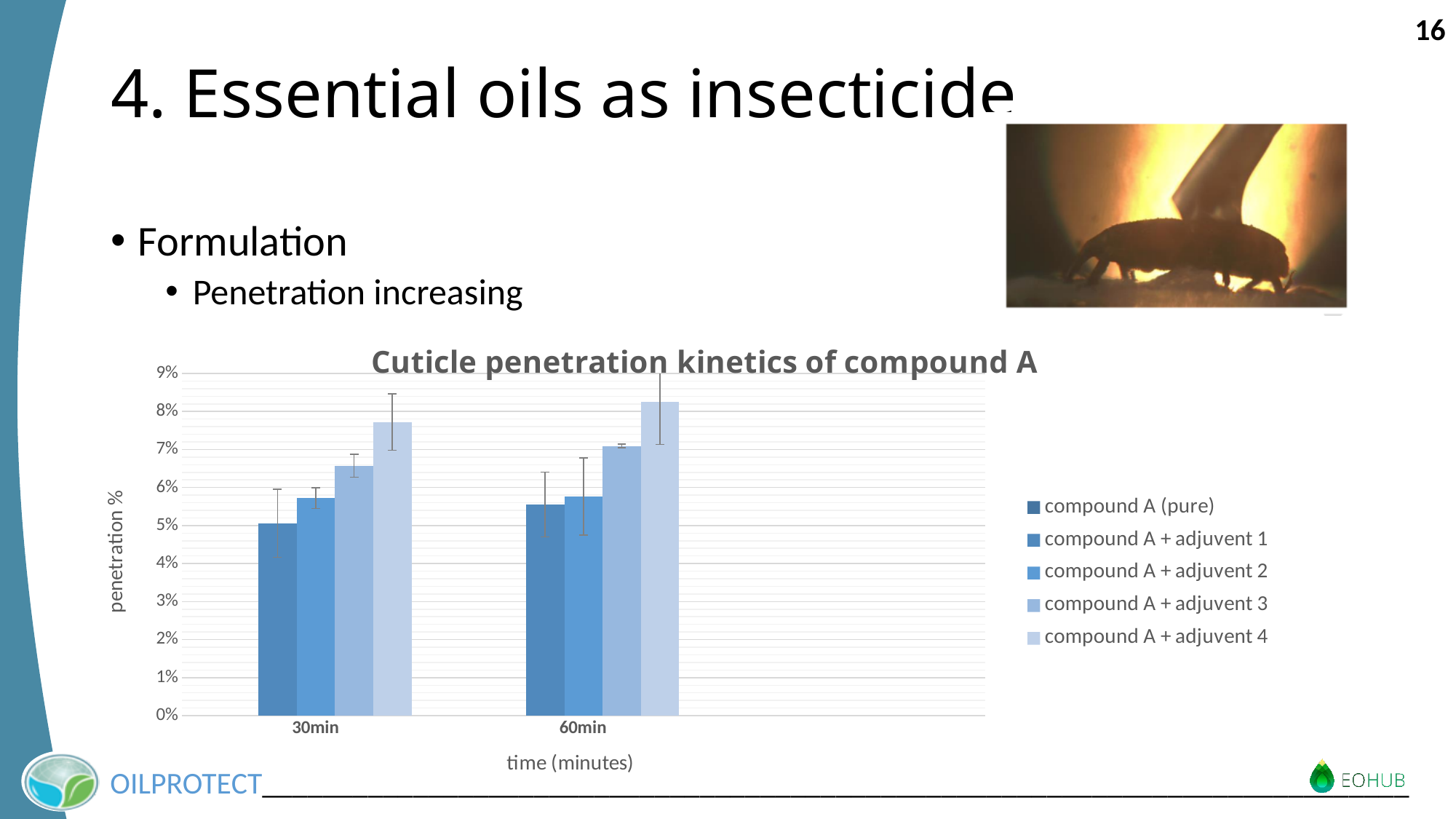
How many time categories are shown on the x axis of the chart? 2 Is the tallest bar at 60min larger or smaller than the tallest bar at 30min? larger Is the value for compound A (pure) at 60min greater or less than 6%? less What type of chart is shown on the slide? bar chart Is the value for compound A (pure) at 30min greater or less than 6%? less Is the tallest bar in the 30min group greater or less than 7%? greater Which time category contains the tallest bar in the chart? 60min How many series does the chart legend list? 5 What is the title of the chart? Cuticle penetration kinetics of compound A What is the label of the y axis of the chart? penetration % Do the penetration values rise or fall from 30min to 60min? rise